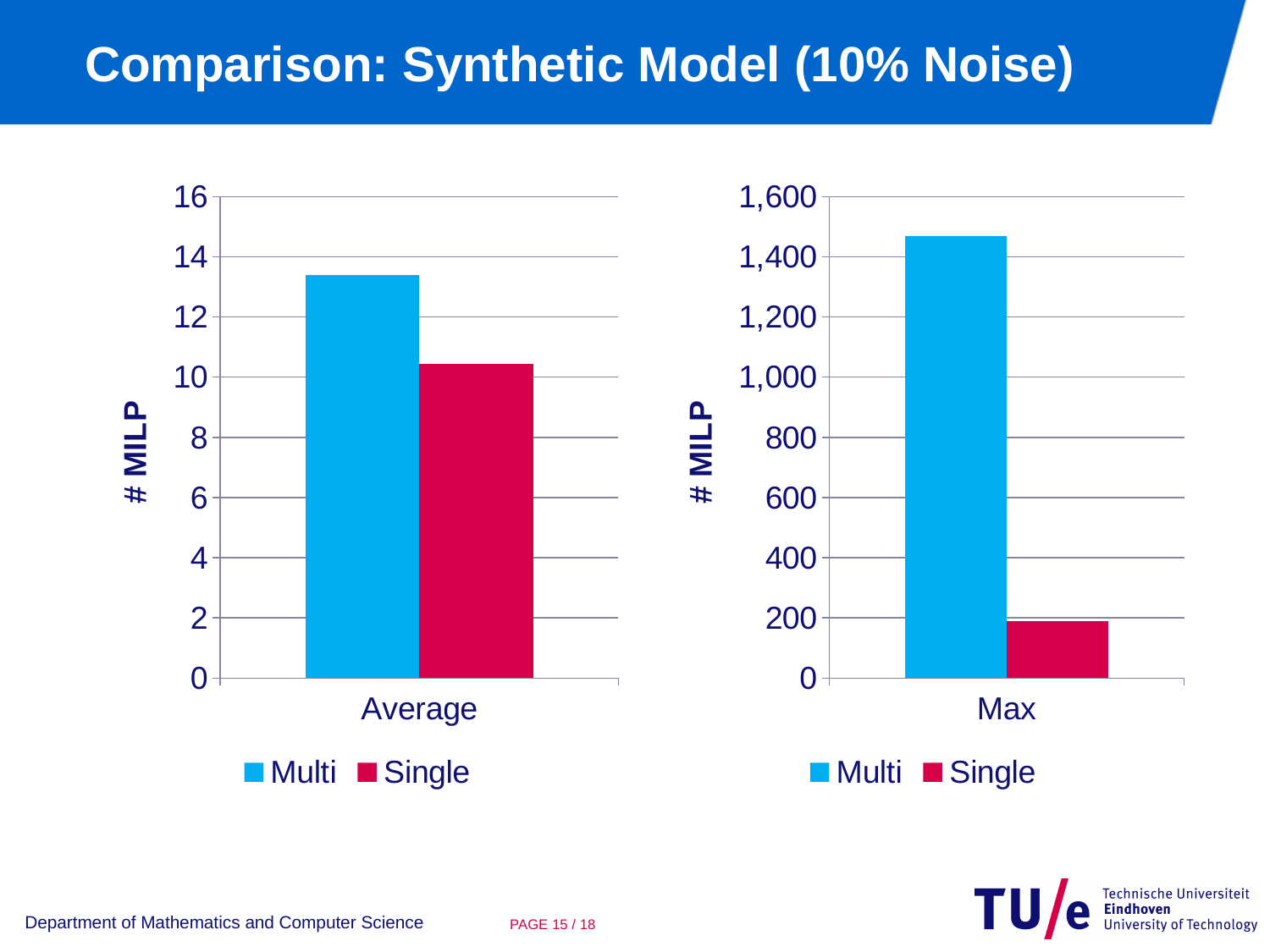
In the left chart (Average), what kind of chart is shown? bar chart In the right chart (Max), which series has the smaller value, Multi or Single? Single In the right chart (Max), which colour represents the Single series? red In the right chart (Max), how many categories are shown on the x axis? 1 In the right chart (Max), is the value for Multi greater or less than 1,400? greater In the left chart (Average), what is the label on the y axis? # MILP In the right chart (Max), is the value for Single greater or less than 400? less In the right chart (Max), how many series does the legend list? 2 In the left chart (Average), is the value for Multi greater or less than 12? greater In the left chart (Average), which series has the larger value, Multi or Single? Multi